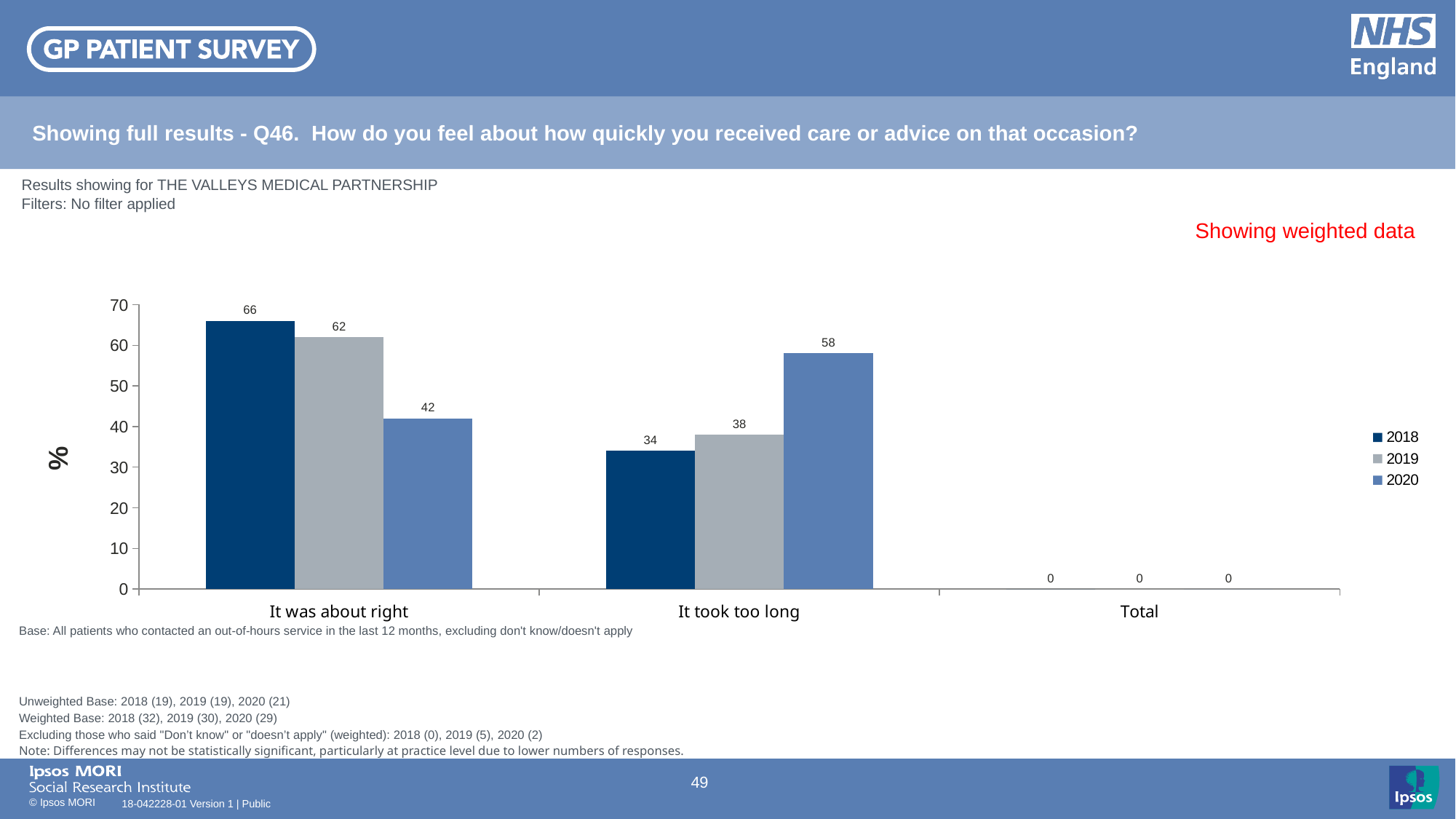
What is the difference between the 2018 and 2020 values for 'It was about right'? 24 How many categories are shown on the x axis? 3 What is the value for 2020 in the 'It took too long' category? 58 Is the 2018 value for 'It took too long' greater or less than 40? less Which is larger: the 2019 value for 'It was about right' or the 2019 value for 'It took too long'? It was about right What is the value for 2019 in the 'It was about right' category? 62 What kind of chart is shown on the slide? bar chart Which year has the lowest value in the 'It was about right' category? 2020 Which year has the highest value in the 'It took too long' category? 2020 How many series does the legend list? 3 What is the value for 2018 in the 'It was about right' category? 66 Do the values for 'It took too long' rise or fall from 2018 to 2020? rise